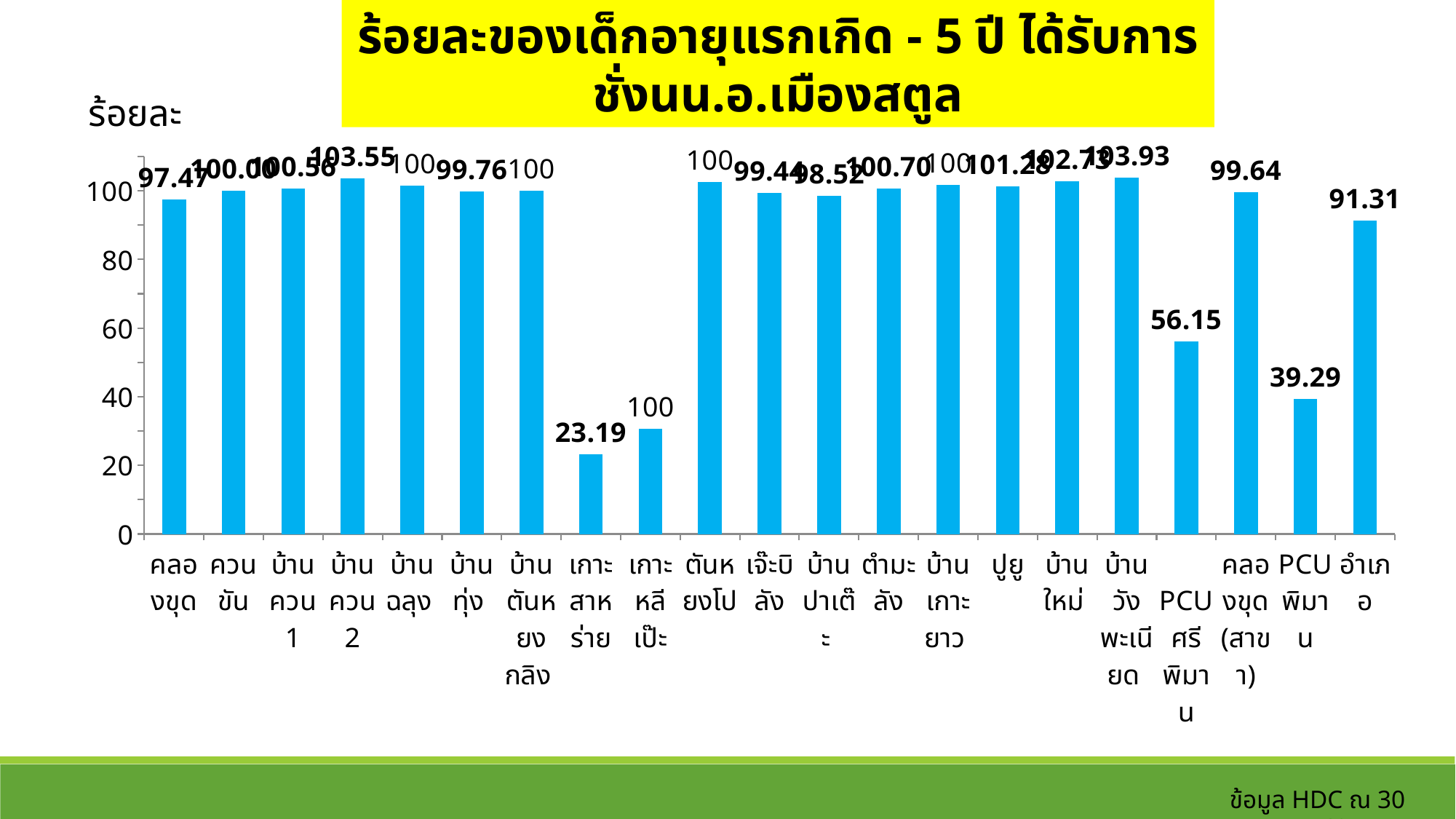
What type of chart is shown on the slide? bar chart Which is larger, the value for PCU ศรีพิมาน or the value for PCU พิมาน? PCU ศรีพิมาน What is the value for PCU ศรีพิมาน? 56.15 What is the value for อำเภอ? 91.31 Which category has the lowest value? เกาะสาหร่าย What is the label on the vertical axis of the chart? ร้อยละ What is the value for เกาะสาหร่าย? 23.19 What is the value for คลองขุด (the first bar)? 97.47 What is the value for PCU พิมาน? 39.29 Is the value for อำเภอ greater or less than 80? greater Which category has the highest value? บ้านวังพะเนียด What is the difference between the values for PCU ศรีพิมาน and PCU พิมาน? 16.86